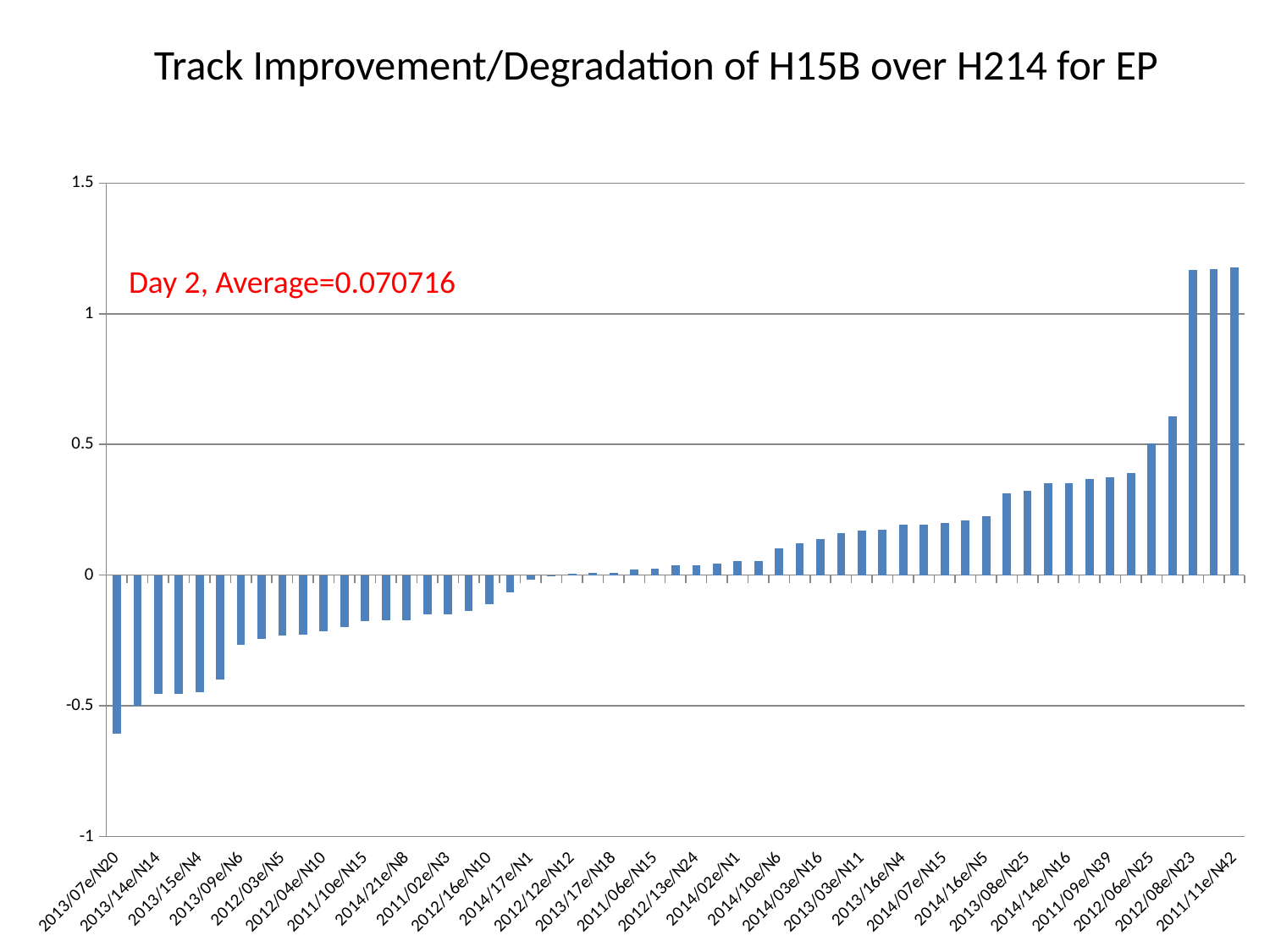
Is the value for 2013/08e/N25 greater or less than 0? greater Is the value for 2013/15e/N4 greater or less than 0? less Is the value for 2011/11e/N42 greater or less than 1? greater What is the highest value shown on the vertical axis? 1.5 What is the title of the chart? Track Improvement/Degradation of H15B over H214 for EP Do the bar values rise or fall from left to right along the x axis? rise Which is larger, the value for 2013/07e/N20 or the value for 2011/11e/N42? 2011/11e/N42 What kind of chart is shown on the slide? bar chart What average value is stated in the red text on the chart? 0.070716 Which category has the lowest value? 2013/07e/N20